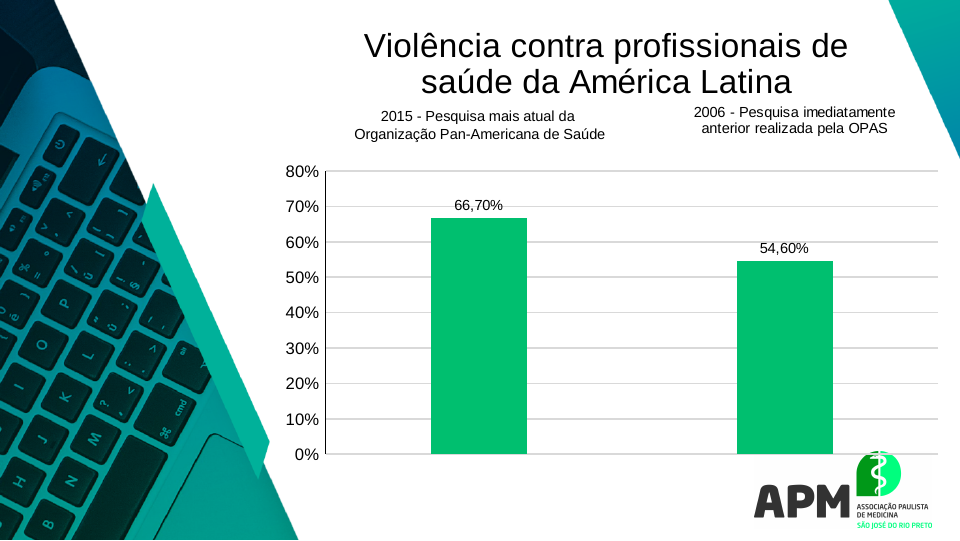
Which survey year has the lower bar, 2015 or 2006? 2006 Is the value for 2006 larger or smaller than the value for 2015? smaller What is the title of the slide containing the chart? Violência contra profissionais de saúde da América Latina What kind of chart is shown on the slide? bar chart What is the value of the bar for the 2006 survey (Pesquisa imediatamente anterior realizada pela OPAS)? 54,60% What is the maximum value shown on the vertical axis of the chart? 80% Is the value for the 2006 survey greater or less than 60%? less What is the difference between the 2015 value and the 2006 value? 12,10% Is the value for the 2015 survey greater or less than 60%? greater What is the value of the bar for the 2015 survey (Pesquisa mais atual da Organização Pan-Americana de Saúde)? 66,70% How many bars are plotted in the chart? 2 Which survey year has the higher bar, 2015 or 2006? 2015